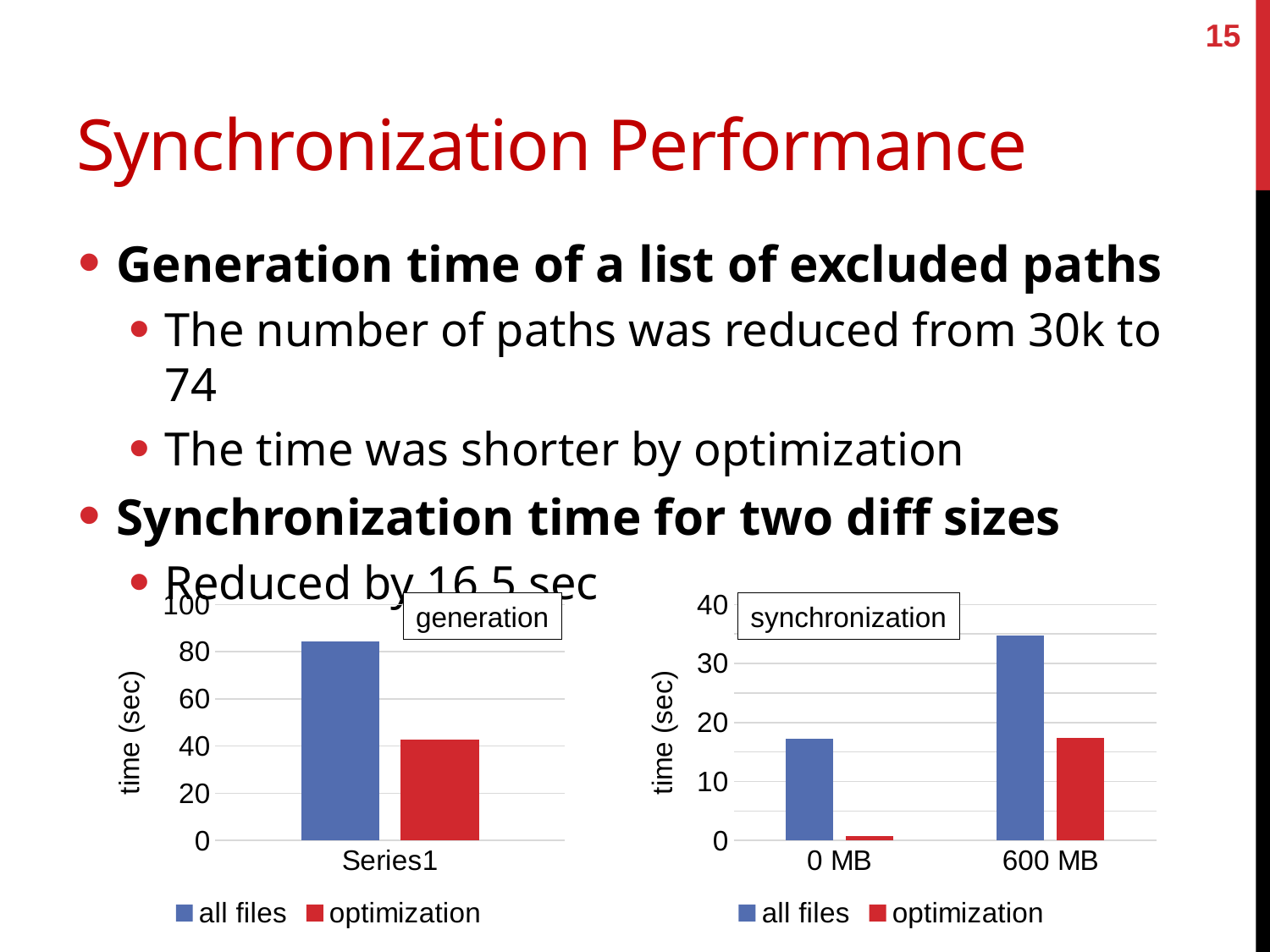
What colour represents the optimization series in the generation chart? red In the generation chart, is the value for optimization greater or less than 60? less In the generation chart, which series has the larger value, all files or optimization? all files In the synchronization chart, which category has the higher all files value, 0 MB or 600 MB? 600 MB In the synchronization chart, which bar is the lowest? optimization at 0 MB In the synchronization chart, is the all files value for 600 MB greater or less than 30? greater In the generation chart, is the value for all files greater or less than 80? greater How many series does the legend of the synchronization chart list? 2 What is the y-axis label of the synchronization chart? time (sec) What kind of chart is the generation chart on the left? bar chart How many categories are shown on the x axis of the synchronization chart? 2